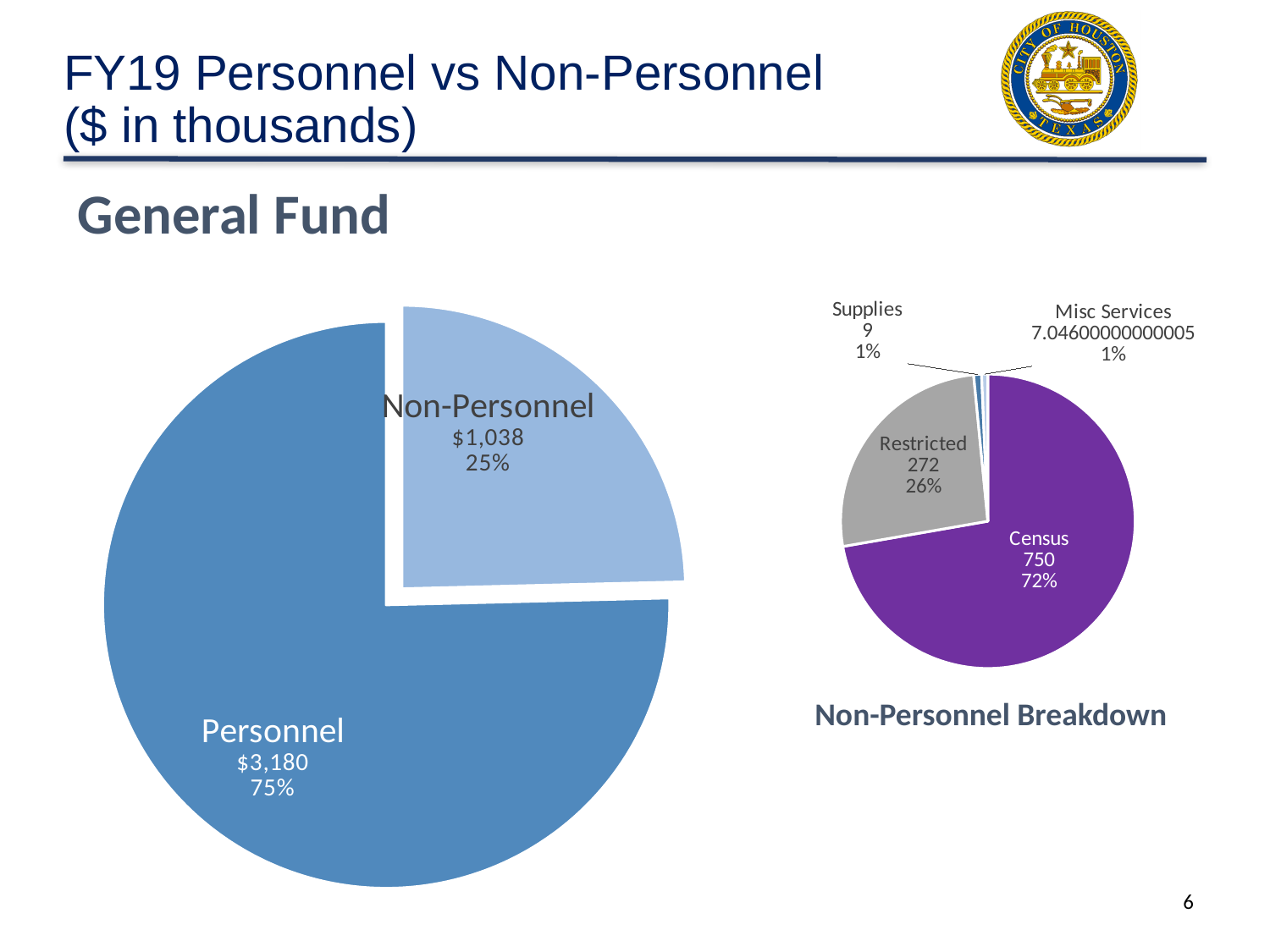
In the General Fund pie chart on the left, how many slices are there? 2 What kind of chart is the Non-Personnel Breakdown chart? Pie chart In the General Fund pie chart on the left, what share of the pie does Non-Personnel represent? 25% In the General Fund pie chart on the left, which category is the largest? Personnel In the Non-Personnel Breakdown chart, what share of the pie does Census represent? 72% In the Non-Personnel Breakdown chart, what is the difference between the Census value and the Restricted value? 478 In the Non-Personnel Breakdown chart, what is the value for Restricted? 272 In the Non-Personnel Breakdown chart, how many slices are there? 4 In the General Fund pie chart on the left, what is the value for Non-Personnel? $1,038 In the Non-Personnel Breakdown chart, which category is the largest? Census In the General Fund pie chart on the left, what is the value for Personnel? $3,180 In the Non-Personnel Breakdown chart, what is the value for Census? 750